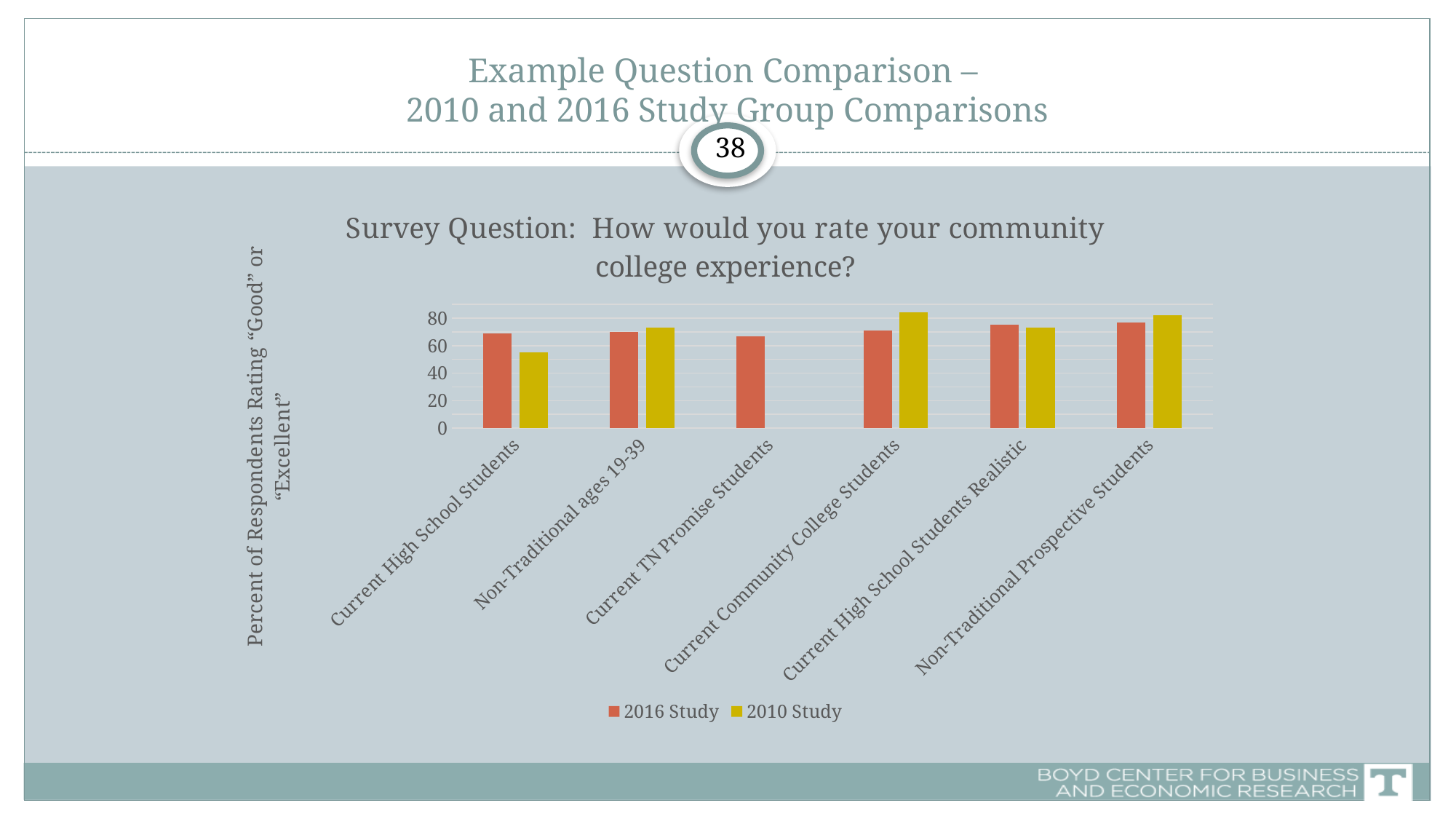
How many series does the legend list? 2 For Current Community College Students, which is larger: the 2016 Study value or the 2010 Study value? 2010 Study What is the y-axis label of the chart? Percent of Respondents Rating "Good" or "Excellent" Which category has no 2010 Study bar? Current TN Promise Students Is the 2016 Study value for Current High School Students greater or less than 80? less Which category has the lowest 2010 Study value? Current High School Students How many categories are shown on the x axis? 6 Is the 2016 Study value for Current TN Promise Students greater or less than 60? greater Is the 2010 Study value for Current Community College Students greater or less than 80? greater What kind of chart is shown on the slide? Bar chart For Current High School Students, which is larger: the 2016 Study value or the 2010 Study value? 2016 Study